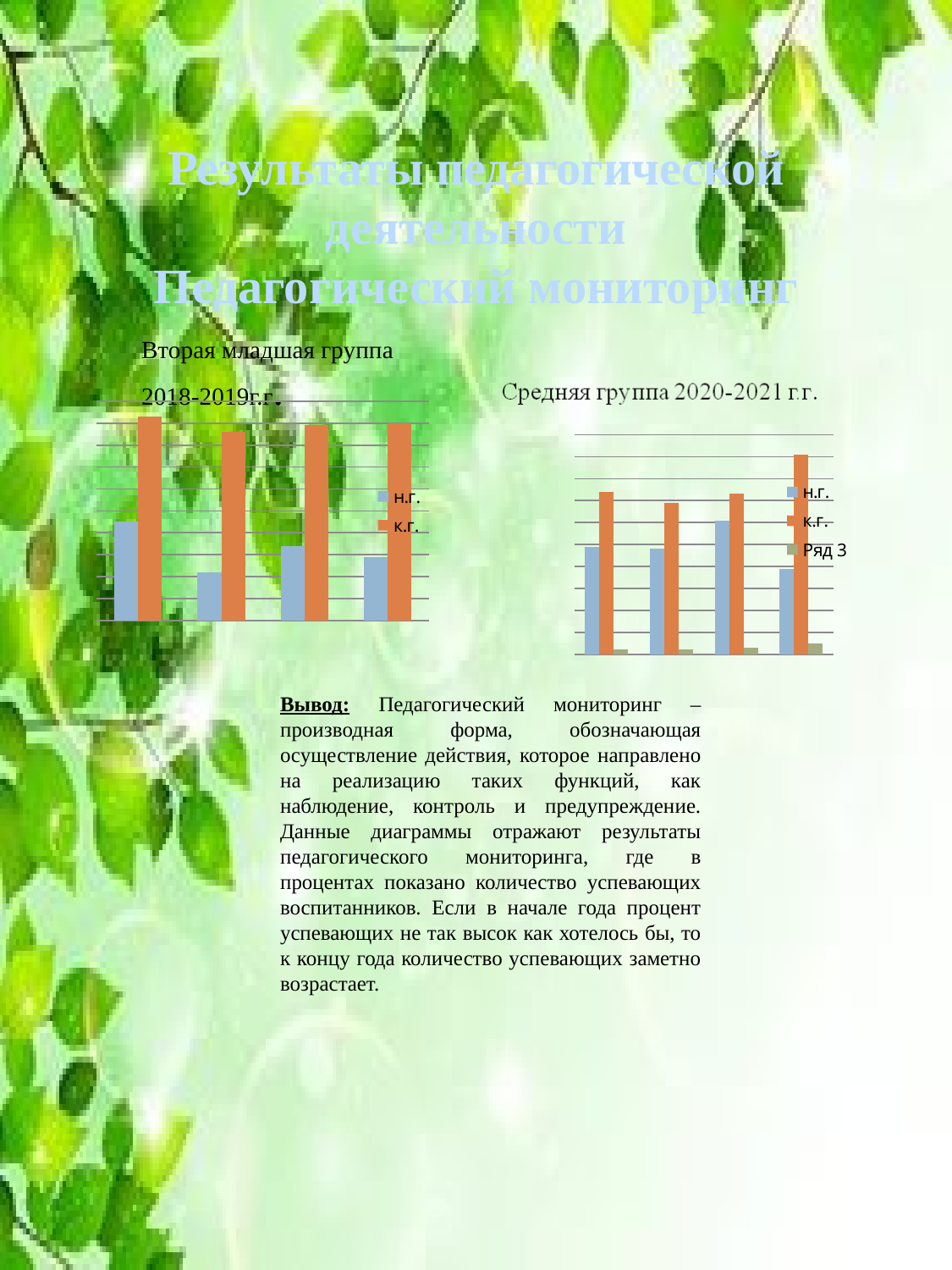
How many series does the legend of the chart 'Вторая младшая группа 2018-2019 г.г.' list? 2 What kind of chart is the chart titled 'Вторая младшая группа 2018-2019 г.г.'? bar chart In the chart 'Средняя группа 2020-2021 г.г.', which group of bars has the highest к.г. value? the fourth group from the left How many series does the legend of the chart 'Средняя группа 2020-2021 г.г.' list? 3 What kind of chart is the chart titled 'Средняя группа 2020-2021 г.г.'? bar chart In the chart 'Вторая младшая группа 2018-2019 г.г.', which series is larger in the first group of bars, н.г. or к.г.? к.г. How many groups of bars are plotted in the chart 'Вторая младшая группа 2018-2019 г.г.'? 4 How many groups of bars are plotted in the chart 'Средняя группа 2020-2021 г.г.'? 4 In the chart 'Средняя группа 2020-2021 г.г.', which series is larger in the fourth group of bars, н.г. or к.г.? к.г. In the chart 'Вторая младшая группа 2018-2019 г.г.', which group of bars has the lowest н.г. value? the second group from the left What is the name of the third legend entry in the chart 'Средняя группа 2020-2021 г.г.'? Ряд 3 In the chart 'Средняя группа 2020-2021 г.г.', which group of bars has the highest н.г. value? the third group from the left